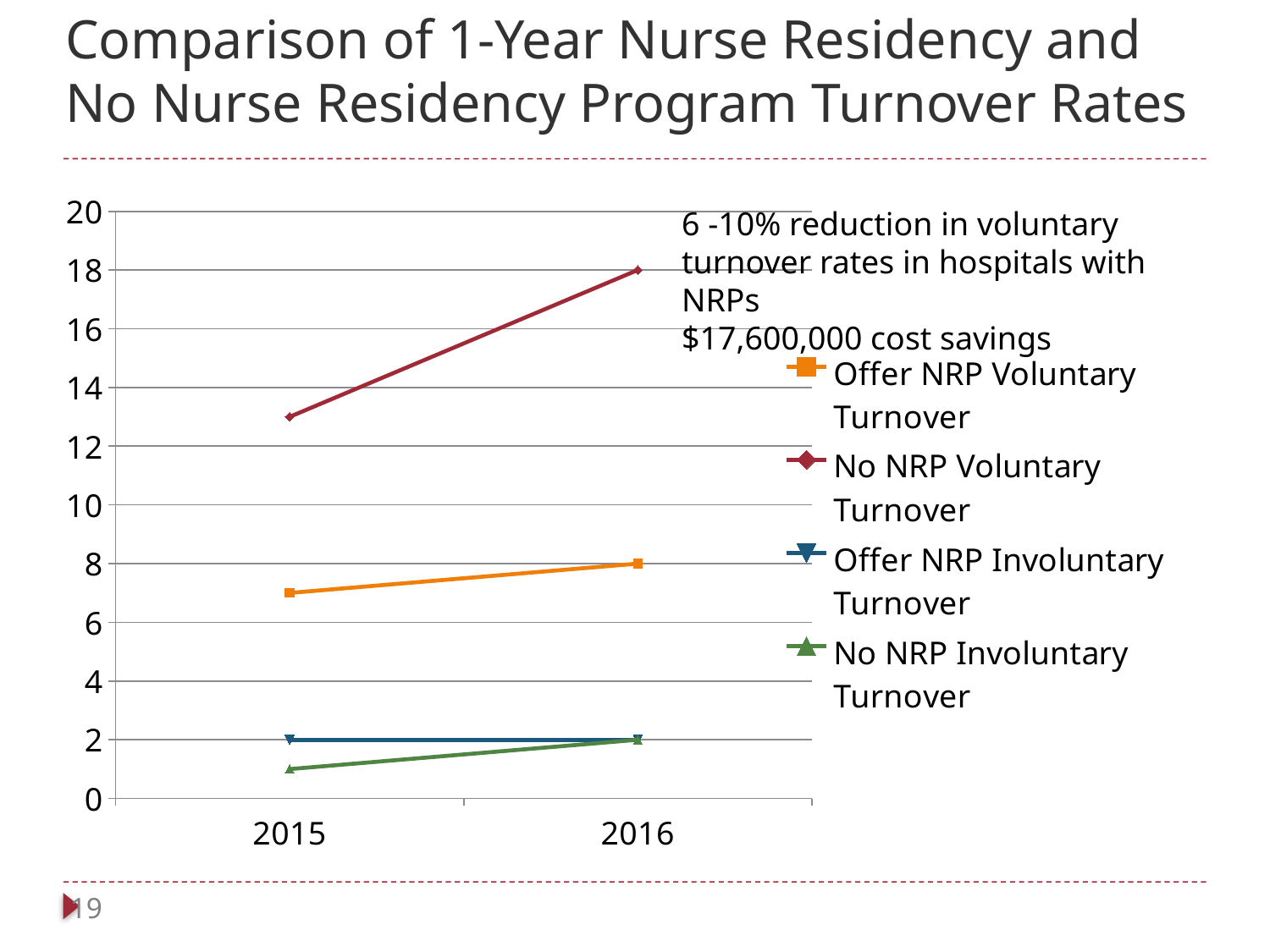
What type of chart is shown on the slide? line chart Which series has the lowest value in 2015? No NRP Involuntary Turnover What is the difference between the No NRP Voluntary Turnover and Offer NRP Voluntary Turnover values in 2016? 10 Is the Offer NRP Voluntary Turnover value in 2015 greater or less than 8? less Is the No NRP Voluntary Turnover value in 2015 greater or less than 12? greater What is the Offer NRP Involuntary Turnover value in 2015? 2 How many years are shown on the x axis? 2 Does the No NRP Voluntary Turnover line rise or fall from 2015 to 2016? rise Which series has the highest value in 2016? No NRP Voluntary Turnover What is the Offer NRP Voluntary Turnover value in 2016? 8 How many series does the legend list? 4 What is the No NRP Voluntary Turnover value in 2016? 18